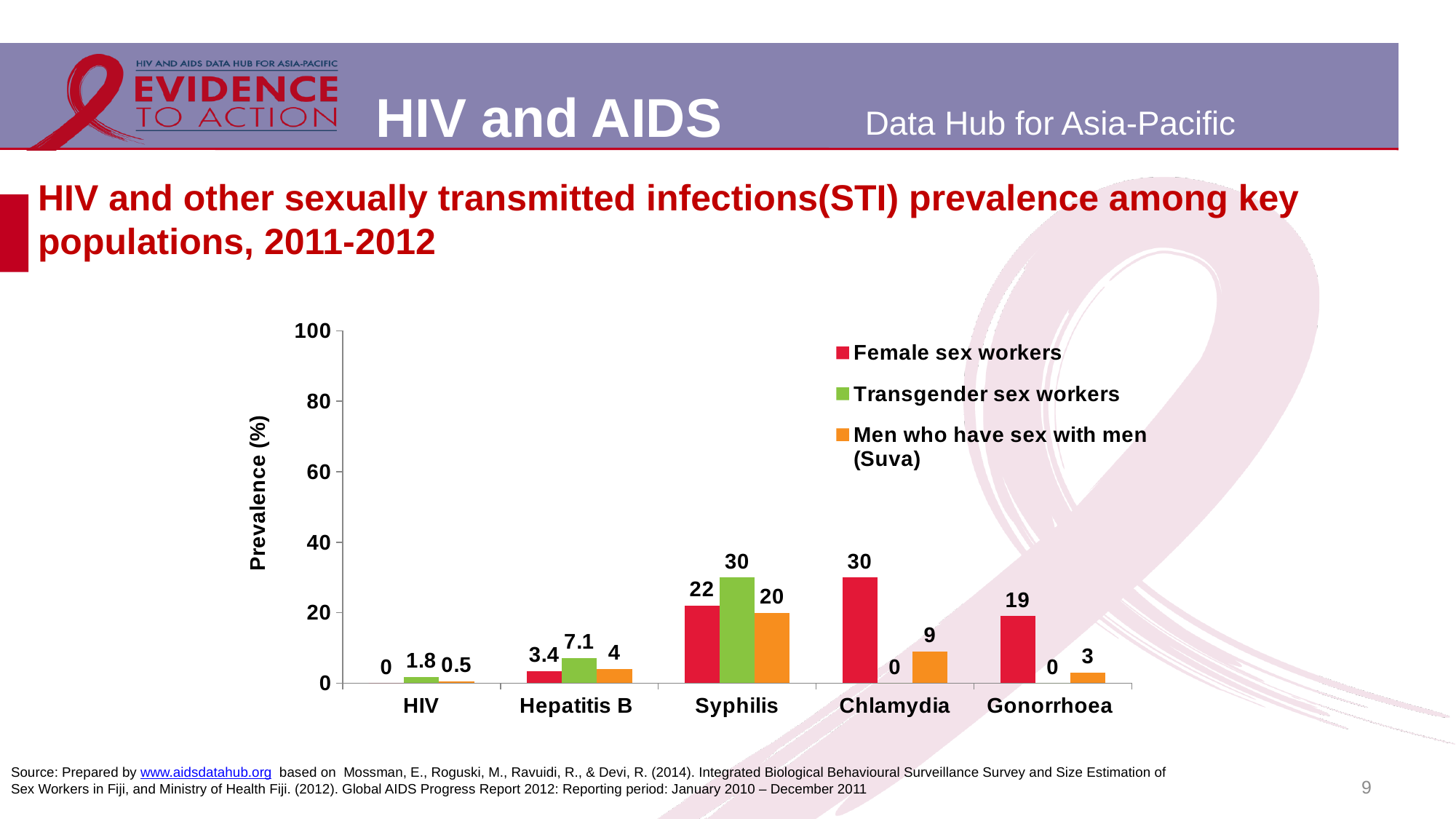
What is the prevalence for men who have sex with men (Suva) for Gonorrhoea? 3 For Hepatitis B, which group has the higher prevalence: transgender sex workers or men who have sex with men (Suva)? Transgender sex workers What is the prevalence for female sex workers for Chlamydia? 30 What kind of chart is shown on the slide? Bar chart For Gonorrhoea, what is the difference between the prevalence for female sex workers and for men who have sex with men (Suva)? 16 Among men who have sex with men (Suva), which infection has the lowest prevalence? HIV What is the prevalence for transgender sex workers for Hepatitis B? 7.1 What is the prevalence for transgender sex workers for Syphilis? 30 Among female sex workers, which infection has the highest prevalence? Chlamydia For Syphilis, what is the difference between the prevalence for transgender sex workers and for men who have sex with men (Suva)? 10 How many infections are shown on the x axis? 5 How many series does the legend list? 3